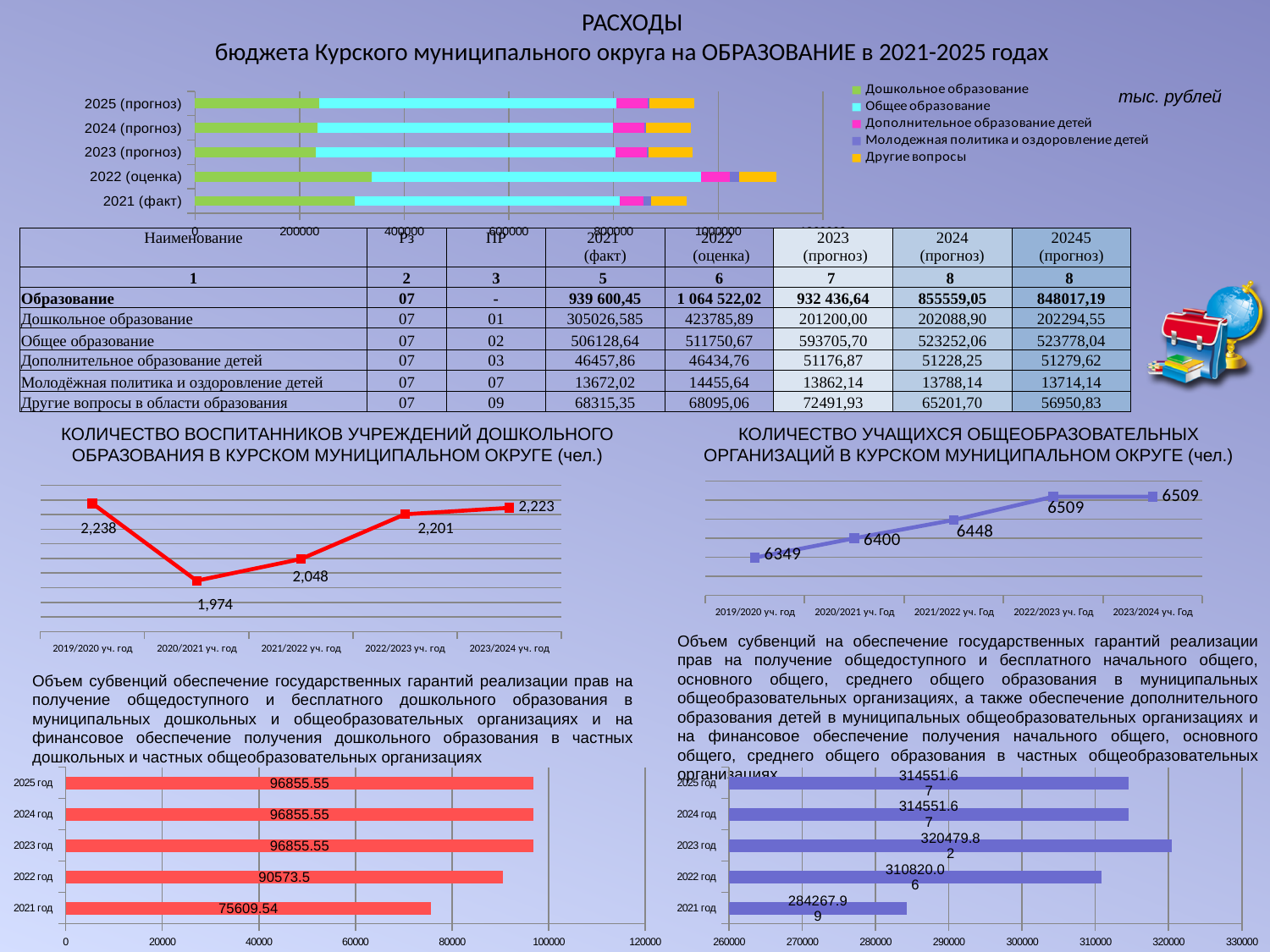
In the line chart 'КОЛИЧЕСТВО ВОСПИТАННИКОВ УЧРЕЖДЕНИЙ ДОШКОЛЬНОГО ОБРАЗОВАНИЯ', what is the difference between the values for 2023/2024 уч. год and 2022/2023 уч. год? 22 In the bottom-right bar chart (subventions for general education), what is the value for 2023 год? 320479.82 In the bottom-right bar chart (subventions for general education), which is larger: the value for 2022 год or 2024 год? 2024 год In the top stacked bar chart of education expenses, is the total for 2022 (оценка) greater or less than 1000000? greater In the line chart 'КОЛИЧЕСТВО ВОСПИТАННИКОВ УЧРЕЖДЕНИЙ ДОШКОЛЬНОГО ОБРАЗОВАНИЯ', what is the value for 2020/2021 уч. год? 1,974 In the bottom-left bar chart (subventions for preschool education), what is the value for 2022 год? 90573.5 In the bottom-left bar chart (subventions for preschool education), which year has the lowest value? 2021 год In the line chart 'КОЛИЧЕСТВО УЧАЩИХСЯ ОБЩЕОБРАЗОВАТЕЛЬНЫХ ОРГАНИЗАЦИЙ', do the values rise or fall from 2019/2020 to 2023/2024? rise In the line chart 'КОЛИЧЕСТВО ВОСПИТАННИКОВ УЧРЕЖДЕНИЙ ДОШКОЛЬНОГО ОБРАЗОВАНИЯ', which academic year has the highest value? 2019/2020 уч. год In the line chart 'КОЛИЧЕСТВО УЧАЩИХСЯ ОБЩЕОБРАЗОВАТЕЛЬНЫХ ОРГАНИЗАЦИЙ', how many data points are plotted? 5 In the line chart 'КОЛИЧЕСТВО УЧАЩИХСЯ ОБЩЕОБРАЗОВАТЕЛЬНЫХ ОРГАНИЗАЦИЙ', what is the value for 2021/2022 уч. Год? 6448 In the top stacked bar chart of education expenses, how many series does the legend list? 5